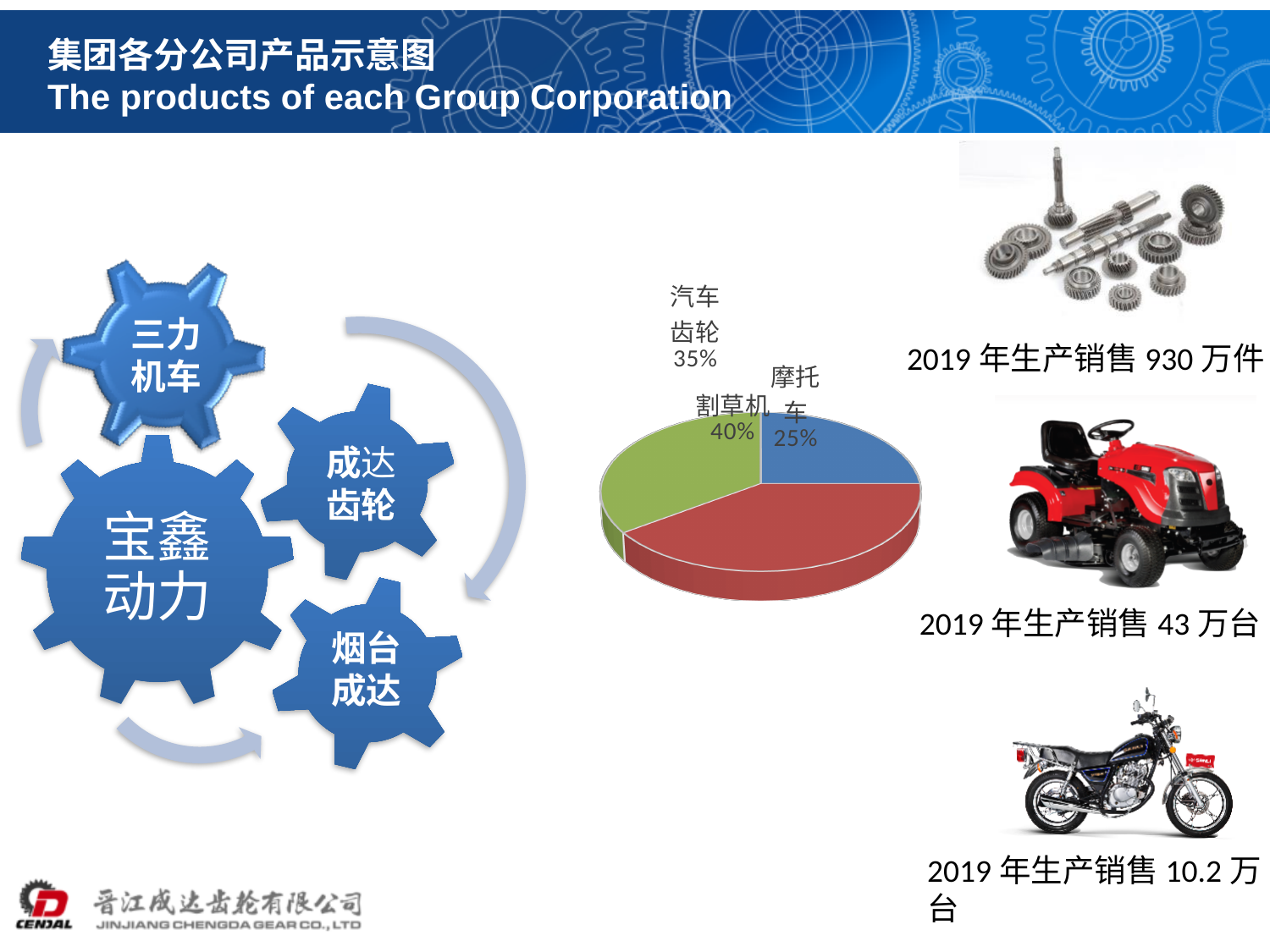
What percentage does the pie chart show for 摩托车? 25% What percentage does the pie chart show for 汽车齿轮? 35% What percentage does the pie chart show for 割草机? 40% Which category has the largest share in the pie chart? 割草机 What is the difference in percentage points between 割草机 and 摩托车 in the pie chart? 15 What is the combined share of 汽车齿轮 and 摩托车 in the pie chart? 60% Which has the larger share in the pie chart, 割草机 or 汽车齿轮? 割草机 What is the difference in percentage points between 汽车齿轮 and 摩托车 in the pie chart? 10 How many slices does the pie chart have? 3 Which category has the smallest share in the pie chart? 摩托车 What kind of chart is shown on the slide? pie chart Which has the larger share in the pie chart, 汽车齿轮 or 摩托车? 汽车齿轮